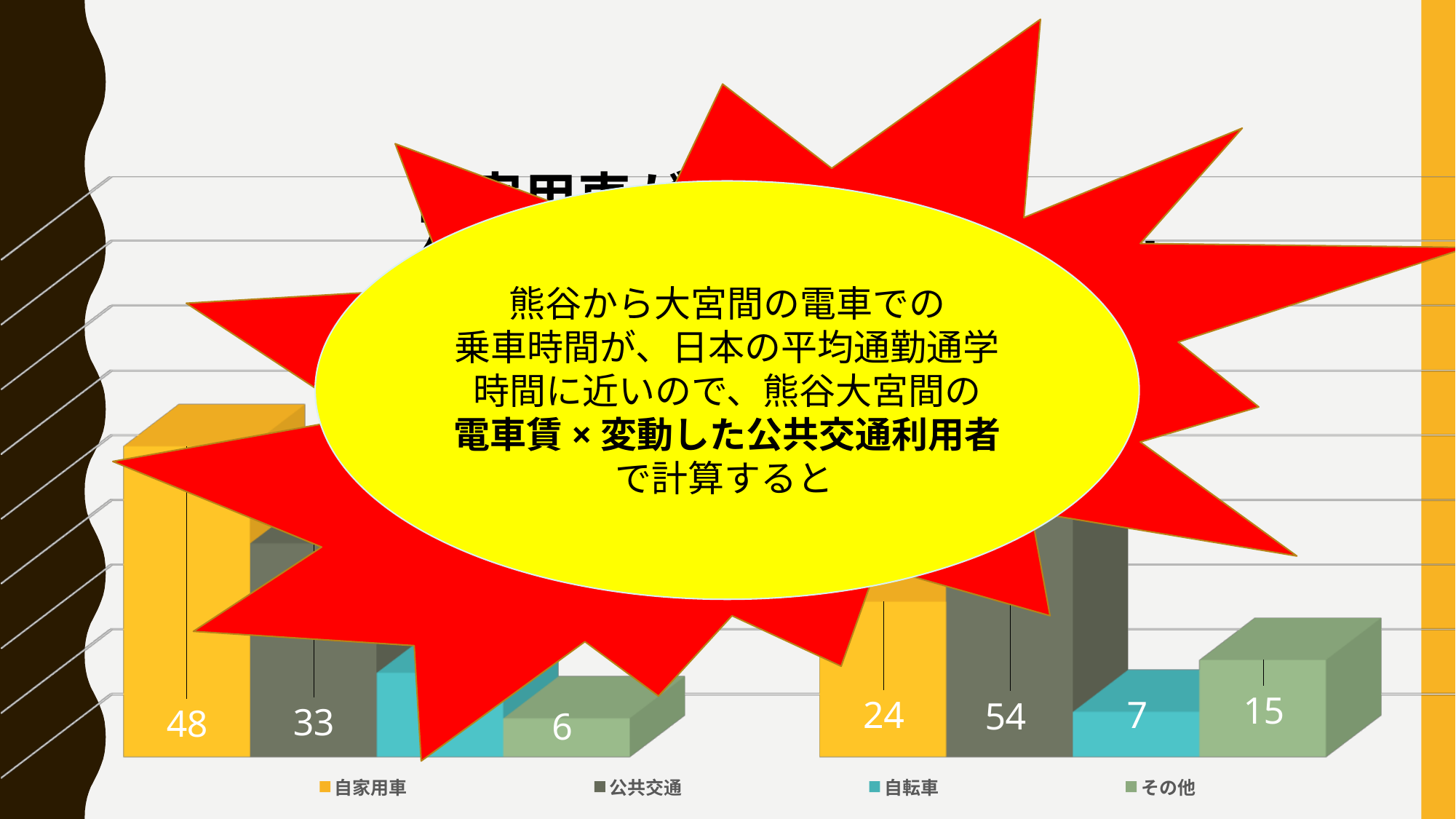
What kind of chart is shown on the slide? bar chart How many groups of bars are plotted in the chart? 2 Which series has the highest value in the right group of bars? 公共交通 How many series does the chart legend list? 4 What is the value of 自家用車 in the left group of bars? 48 What is the value of 公共交通 in the left group of bars? 33 Which colour represents 自家用車 in the legend? yellow What is the difference between the 公共交通 value in the right group (54) and in the left group (33)? 21 What is the value of その他 in the left group of bars? 6 What is the value of 公共交通 in the right group of bars? 54 What is the value of 自転車 in the right group of bars? 7 Which series has the lowest value in the right group of bars? 自転車